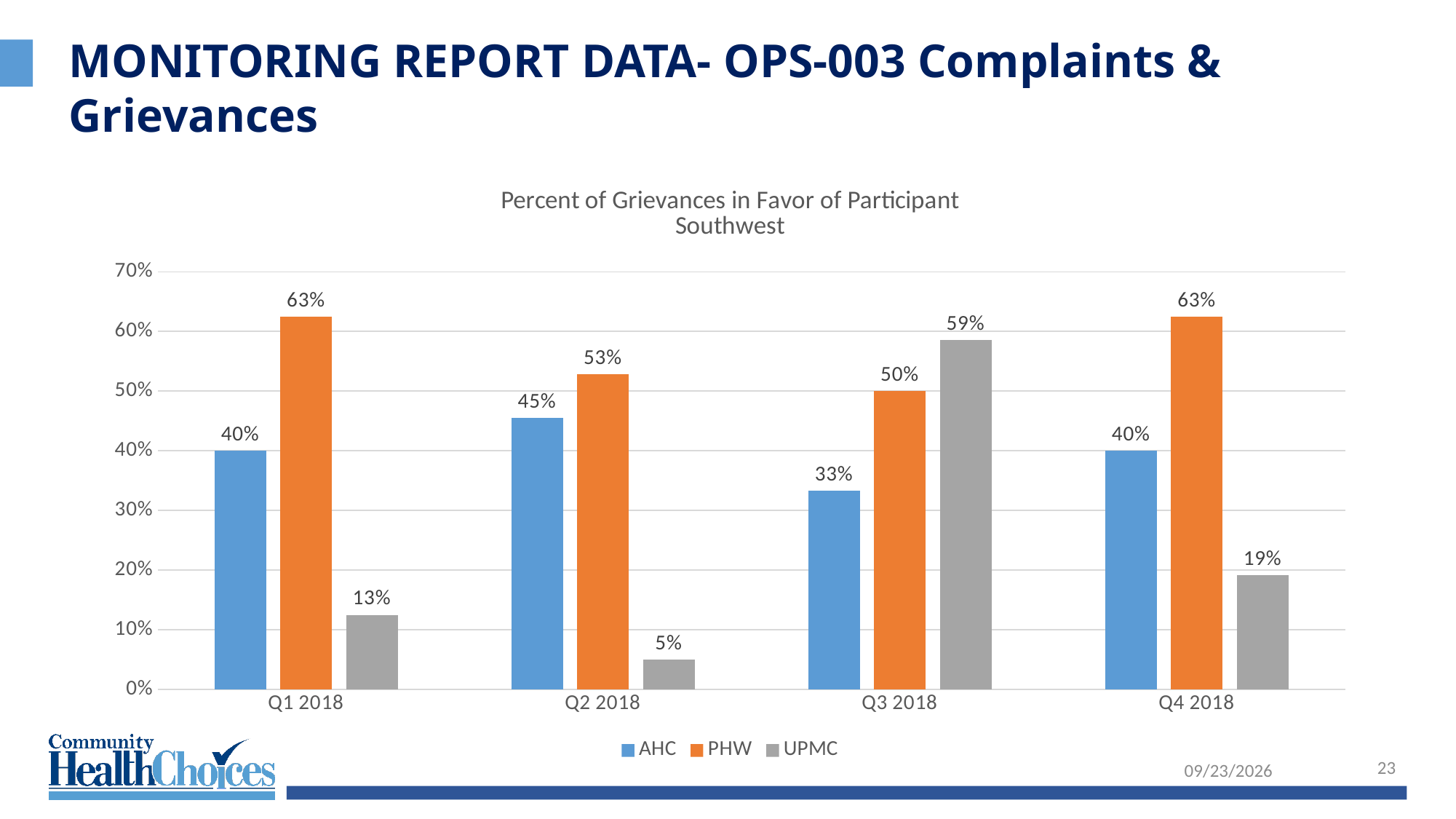
What is the difference between the PHW and AHC values in Q4 2018? 23% What is the title of the chart? Percent of Grievances in Favor of Participant Southwest Do the UPMC values rise or fall from Q2 2018 to Q3 2018? Rise What is the value for UPMC in Q2 2018? 5% What kind of chart is shown on the slide? Bar chart What is the value for AHC in Q3 2018? 33% How many series does the legend list? 3 Which series has the highest value in Q3 2018? UPMC Which quarter has the lowest value for UPMC? Q2 2018 How many quarters are shown on the x axis? 4 What is the value for PHW in Q1 2018? 63% Which is larger in Q2 2018, AHC or PHW? PHW